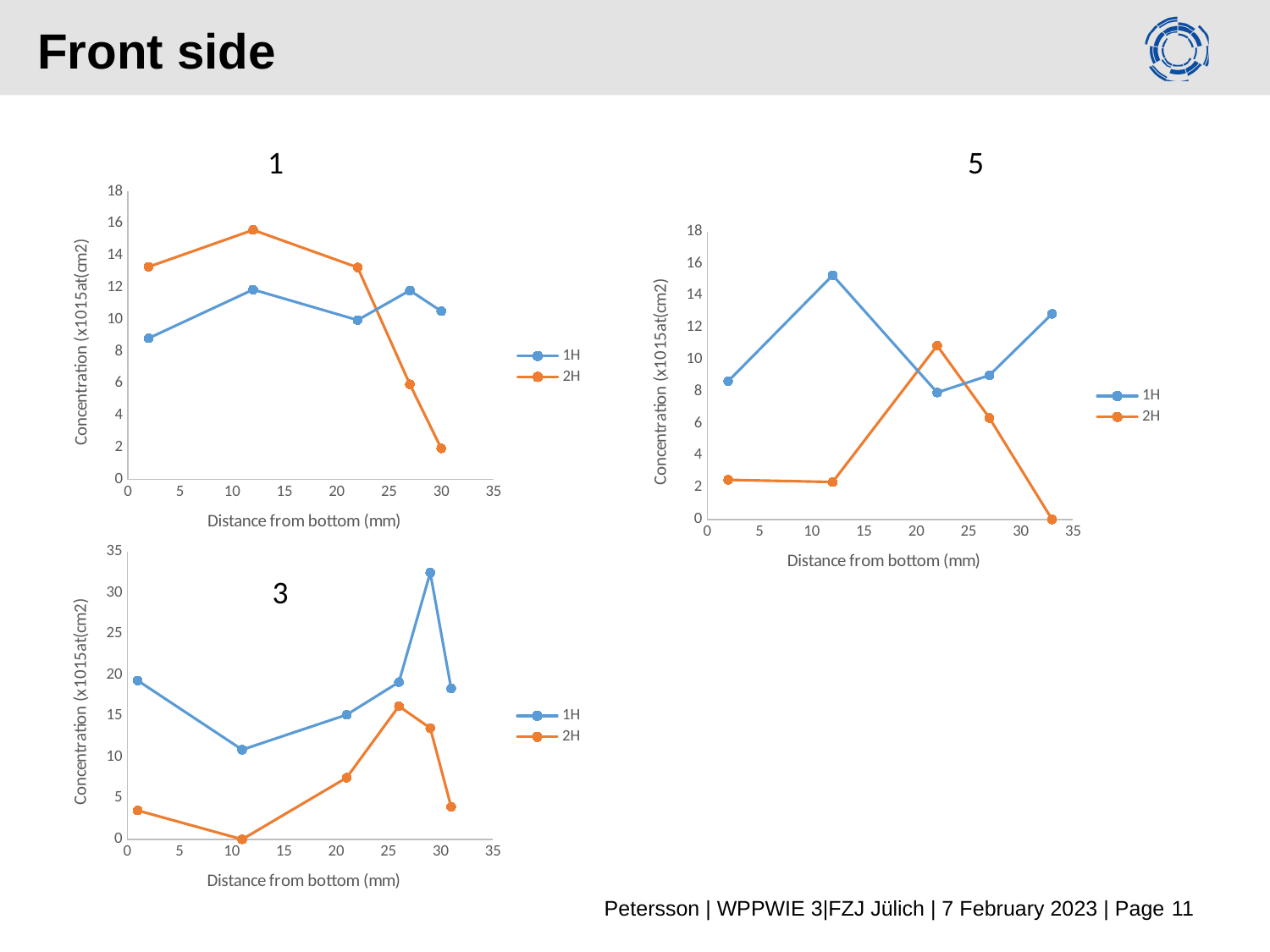
In the chart titled "3", is the peak value of the 1H series greater or less than 30? greater In the chart titled "5", at a distance of 22 mm, which series has the larger value, 1H or 2H? 2H In the chart titled "1", at a distance of 30 mm, which series has the larger value, 1H or 2H? 1H In the chart titled "1", is the 2H value at a distance of 2 mm greater or less than 12? greater What kind of chart is the chart titled "1"? line chart How many data points does the 1H series have in the chart titled "3"? 6 How many series does the legend of the chart titled "5" list? 2 What is the x-axis label of the chart titled "5"? Distance from bottom (mm)